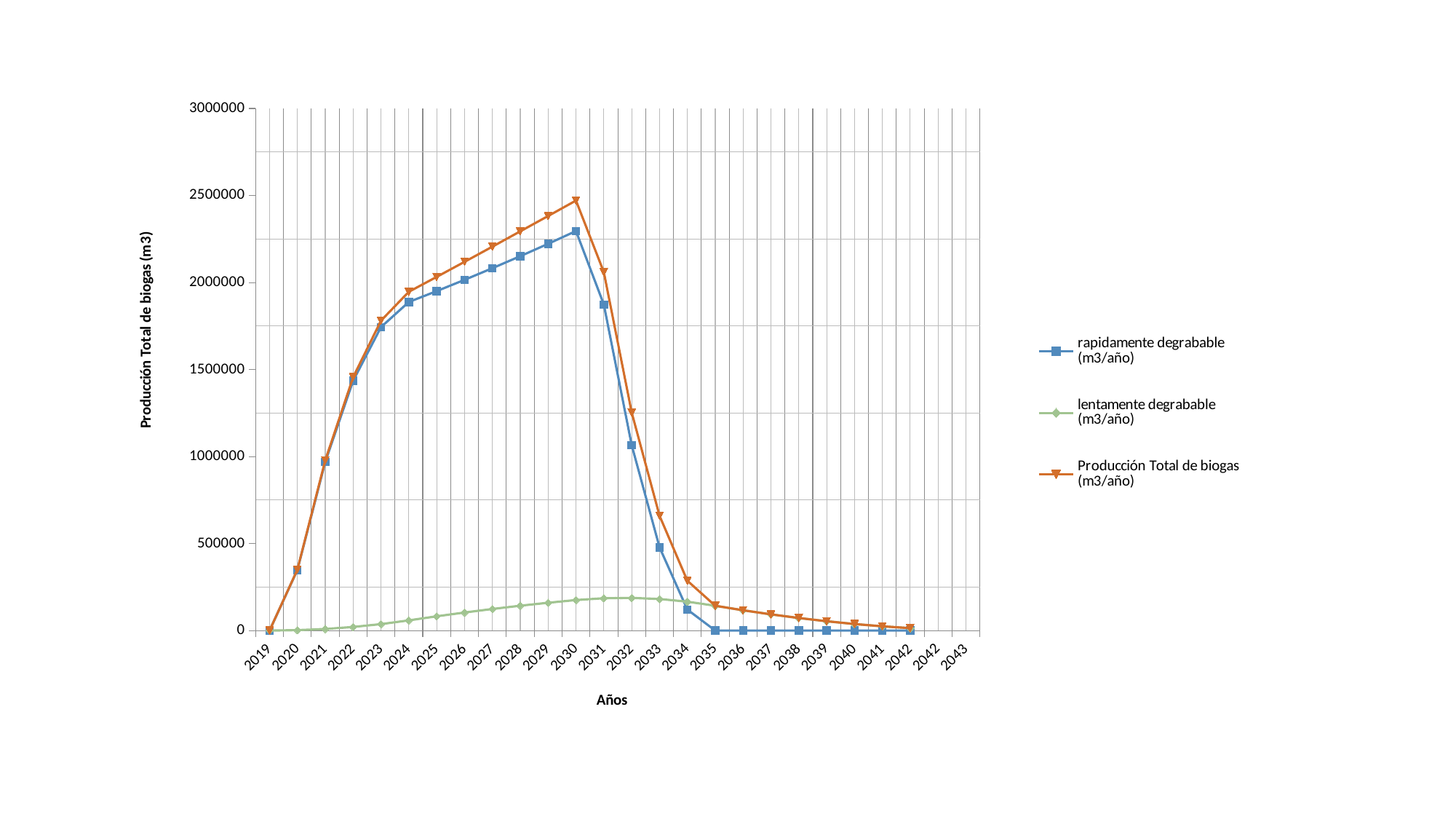
Is the value of rapidamente degrabable (m3/año) in 2033 greater or less than 1000000? less In 2030, which series has the larger value: rapidamente degrabable (m3/año) or lentamente degrabable (m3/año)? rapidamente degrabable (m3/año) Does the Producción Total de biogas (m3/año) series rise or fall between 2019 and 2030? rise How many series does the legend list? 3 In which year does the Producción Total de biogas (m3/año) series reach its highest value? 2030 What is the title of the vertical axis? Producción Total de biogas (m3) What kind of chart is shown on the slide? line chart Does the rapidamente degrabable (m3/año) series rise or fall between 2030 and 2035? fall In 2035, which series has the larger value: rapidamente degrabable (m3/año) or lentamente degrabable (m3/año)? lentamente degrabable (m3/año) Is the value of lentamente degrabable (m3/año) in 2030 greater or less than 500000? less Is the value of Producción Total de biogas (m3/año) in 2030 greater or less than 2000000? greater